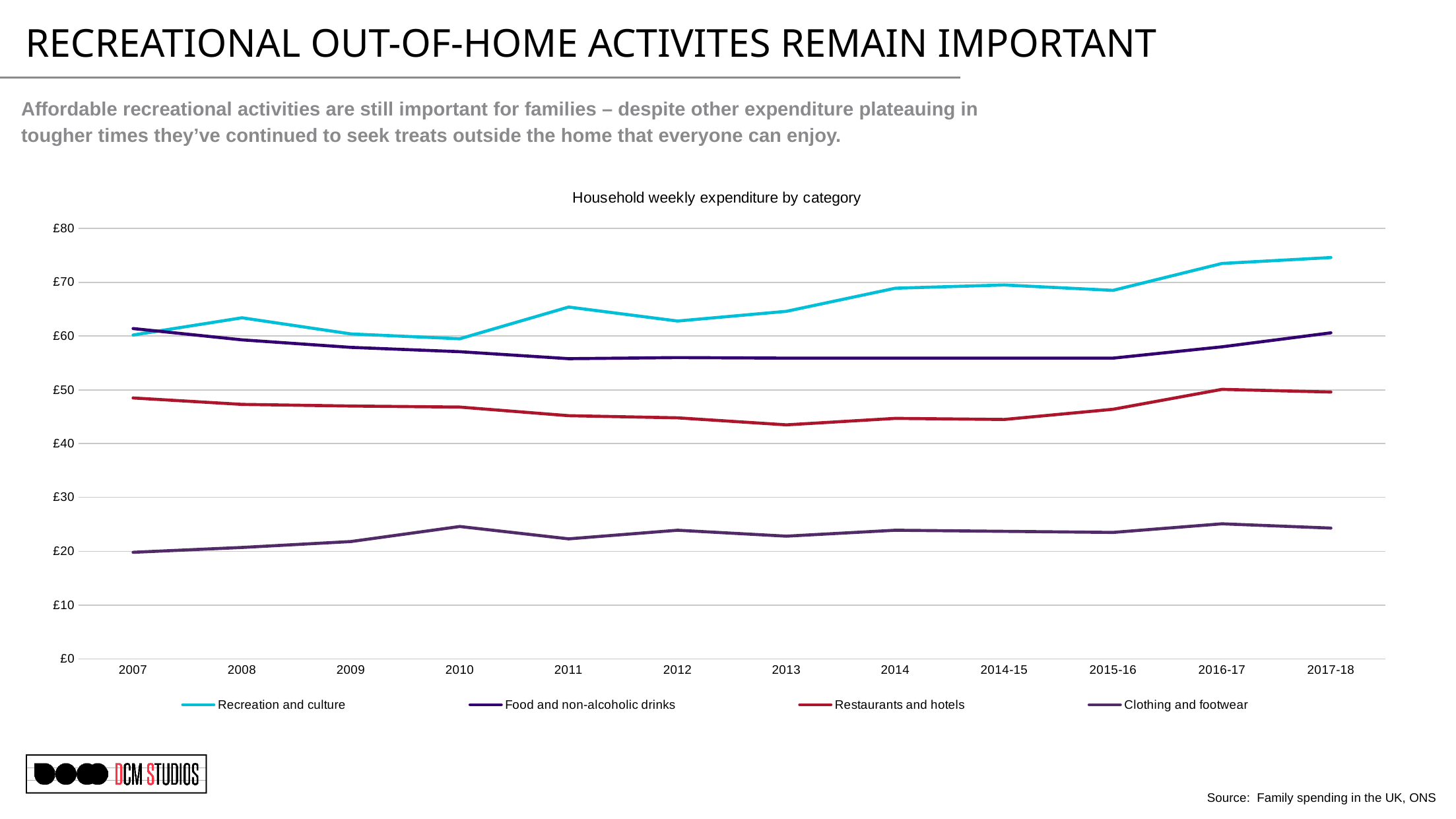
Does the Recreation and culture line rise or fall overall from 2007 to 2017-18? Rise Is the value for Recreation and culture in 2017-18 greater or less than £70? greater Is the value for Restaurants and hotels in 2013 greater or less than £50? less Which series has the lowest values throughout the chart? Clothing and footwear What is the title of the chart? Household weekly expenditure by category In 2017-18, which is larger: Recreation and culture or Food and non-alcoholic drinks? Recreation and culture Is the value for Clothing and footwear in 2007 greater or less than £30? less How many time periods are shown along the x axis? 12 How many series does the legend list? 4 What kind of chart is shown on the slide? Line chart Which series has the highest value in 2017-18? Recreation and culture